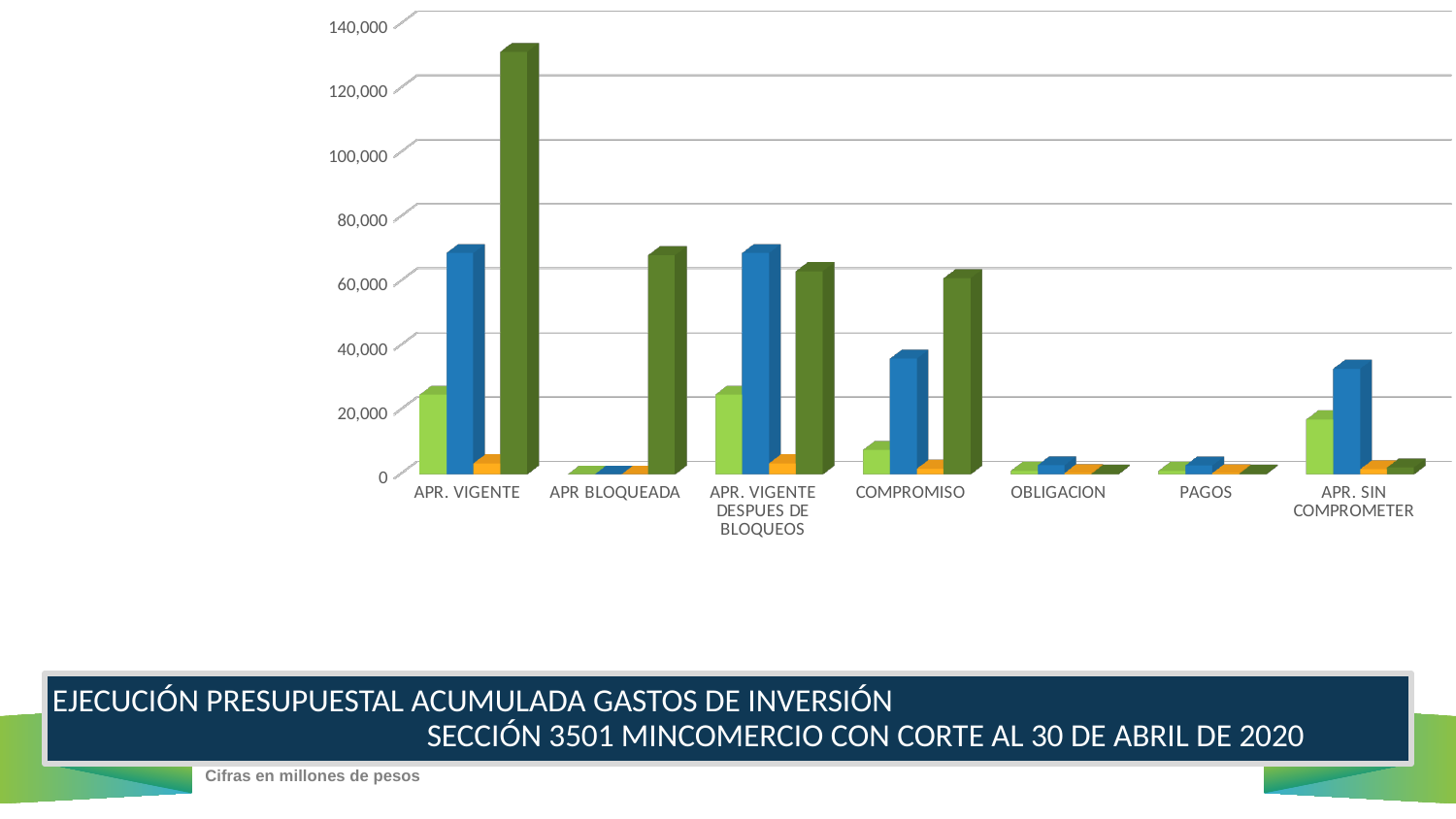
In the COMPROMISO category, which is larger: the blue bar or the dark green bar? The dark green bar Is the value of the dark green bar for APR. VIGENTE greater or less than 120,000? greater What is the highest value shown on the vertical axis of the chart? 140,000 Which category contains the tallest bar in the chart? APR. VIGENTE Is the value of the blue bar for APR. VIGENTE greater or less than 60,000? greater Is the value of the blue bar for COMPROMISO greater or less than 40,000? less What kind of chart is shown on the slide? Bar chart In the APR. SIN COMPROMETER category, which is larger: the light green bar or the blue bar? The blue bar How many categories are shown on the x axis of the chart? 7